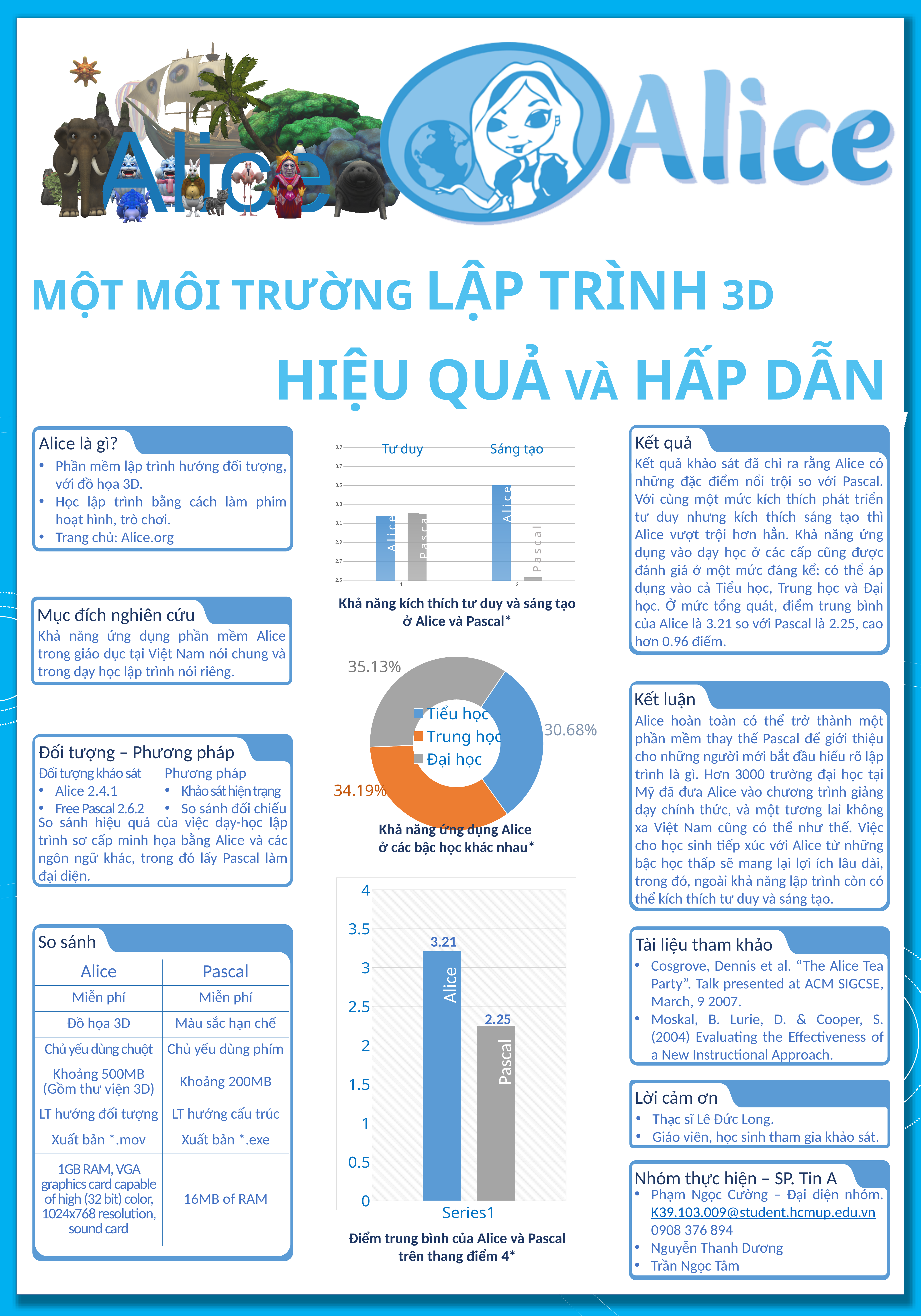
In the bottom chart 'Điểm trung bình của Alice và Pascal trên thang điểm 4*', what is the value for Pascal? 2.25 In the donut chart 'Khả năng ứng dụng Alice ở các bậc học khác nhau*', what is the difference between the Đại học and Tiểu học shares? 4.45% In the donut chart 'Khả năng ứng dụng Alice ở các bậc học khác nhau*', which category has the largest share? Đại học In the bottom chart 'Điểm trung bình của Alice và Pascal trên thang điểm 4*', what is the difference between the Alice and Pascal values? 0.96 In the top chart 'Khả năng kích thích tư duy và sáng tạo ở Alice và Pascal*', which is larger for Sáng tạo, Alice or Pascal? Alice In the donut chart 'Khả năng ứng dụng Alice ở các bậc học khác nhau*', which category has the smallest share? Tiểu học In the donut chart 'Khả năng ứng dụng Alice ở các bậc học khác nhau*', what share does Trung học have? 34.19% In the donut chart 'Khả năng ứng dụng Alice ở các bậc học khác nhau*', how many categories does the legend list? 3 What kind of chart is the bottom chart 'Điểm trung bình của Alice và Pascal trên thang điểm 4*'? Bar chart In the top chart 'Khả năng kích thích tư duy và sáng tạo ở Alice và Pascal*', is the Alice value for Sáng tạo greater or less than 3.3? greater In the bottom chart 'Điểm trung bình của Alice và Pascal trên thang điểm 4*', which has the higher value, Alice or Pascal? Alice In the bottom chart 'Điểm trung bình của Alice và Pascal trên thang điểm 4*', what is the value for Alice? 3.21